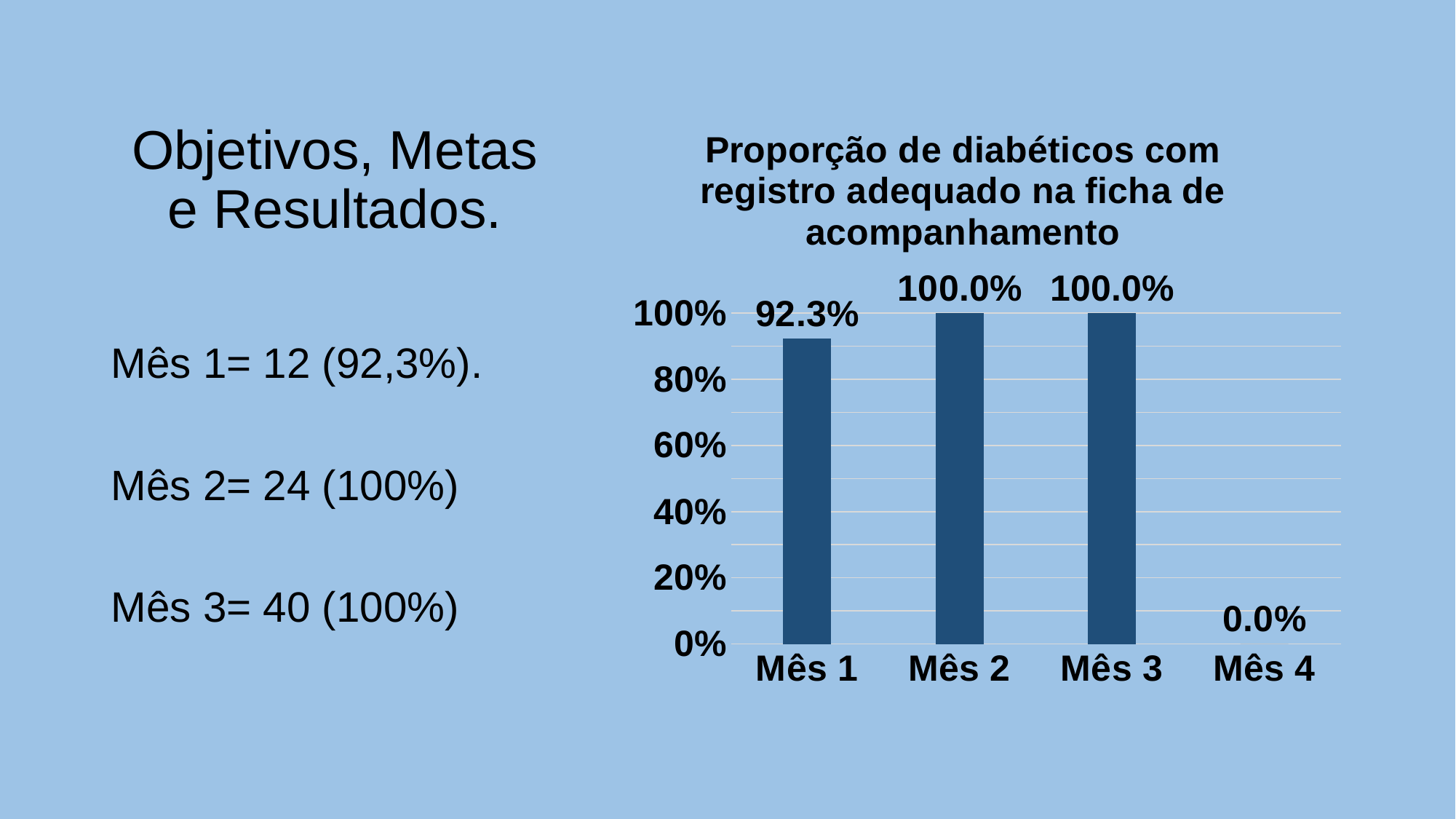
Do the values for Mês 2 and Mês 3 differ? No, both are 100.0% Which is larger, the value for Mês 1 or the value for Mês 3? Mês 3 What is the difference between the values for Mês 2 and Mês 1? 7.7% What is the difference between the values for Mês 3 and Mês 4? 100.0% What is the title of the chart? Proporção de diabéticos com registro adequado na ficha de acompanhamento What is the value for Mês 2? 100.0% Which category has the lowest value? Mês 4 What is the value for Mês 1? 92.3% Is the value for Mês 1 greater or less than 80%? greater What kind of chart is shown? bar chart How many categories are shown on the x axis? 4 What is the value for Mês 4? 0.0%